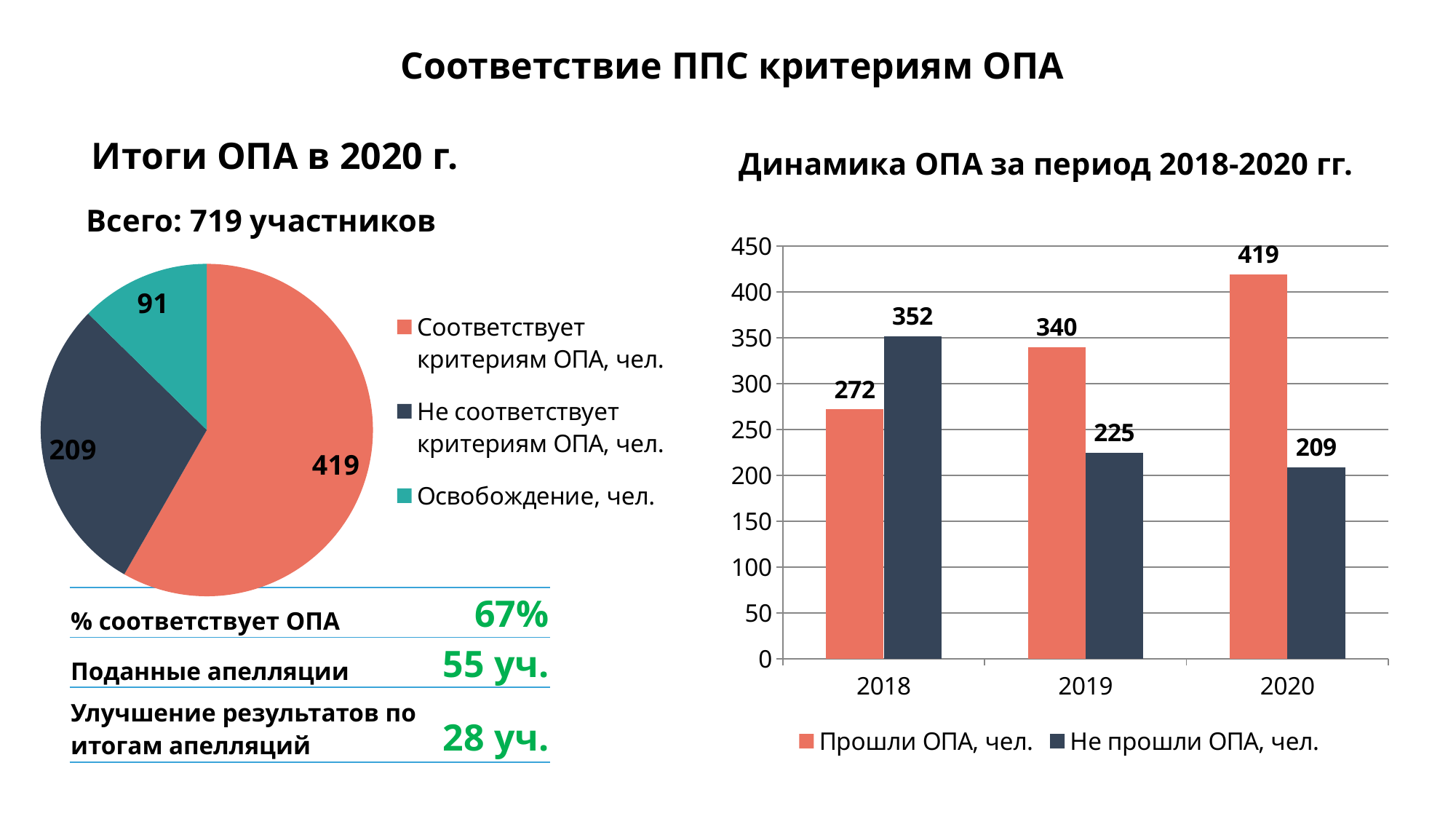
In the bar chart 'Динамика ОПА за период 2018-2020 гг.', what is the difference between 'Прошли ОПА' and 'Не прошли ОПА' in 2020? 210 In the pie chart 'Итоги ОПА в 2020 г.', what is the value for 'Освобождение, чел.'? 91 In the pie chart 'Итоги ОПА в 2020 г.', what is the difference between 'Соответствует критериям ОПА' and 'Не соответствует критериям ОПА'? 210 In the pie chart 'Итоги ОПА в 2020 г.', which category has the smallest slice? Освобождение, чел. In the bar chart 'Динамика ОПА за период 2018-2020 гг.', which year has the highest value for 'Прошли ОПА, чел.'? 2020 In the bar chart 'Динамика ОПА за период 2018-2020 гг.', what is the value for 'Не прошли ОПА, чел.' in 2018? 352 In the bar chart 'Динамика ОПА за период 2018-2020 гг.', what is the value for 'Прошли ОПА, чел.' in 2019? 340 How many series does the legend of the bar chart 'Динамика ОПА за период 2018-2020 гг.' list? 2 In the pie chart 'Итоги ОПА в 2020 г.', what is the value for 'Соответствует критериям ОПА, чел.'? 419 In the bar chart 'Динамика ОПА за период 2018-2020 гг.', does the value for 'Не прошли ОПА, чел.' rise or fall from 2018 to 2020? fall In the bar chart 'Динамика ОПА за период 2018-2020 гг.', which is larger in 2018: 'Прошли ОПА' or 'Не прошли ОПА'? Не прошли ОПА, чел. In the pie chart 'Итоги ОПА в 2020 г.', how many slices are there? 3